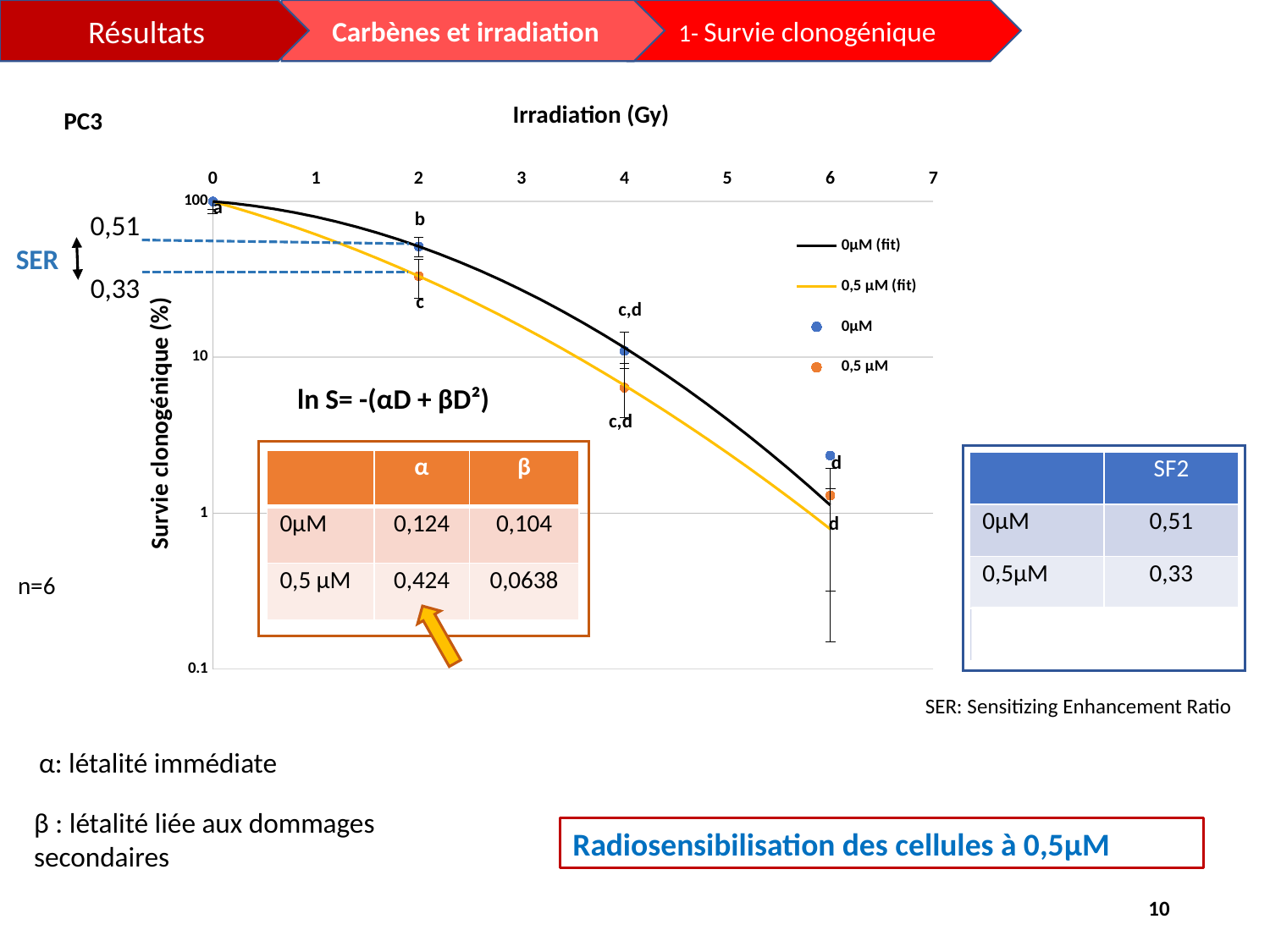
What is the title of the y axis of the chart? Survie clonogénique (%) What is the title of the x axis of the chart? Irradiation (Gy) What kind of chart is shown on the slide? scatter chart with fitted curves How many irradiation doses have plotted data points for each series? 4 At 4 Gy, is the survival value for 0,5 µM greater or less than 10? less At 4 Gy, is the survival value for 0µM greater or less than 10? greater At 6 Gy, which series has the lower clonogenic survival, 0µM or 0,5 µM? 0,5 µM How many entries does the chart legend list? 4 At 6 Gy, is the survival value for 0µM greater or less than 1? greater Does clonogenic survival rise or fall as the irradiation dose increases? fall At 4 Gy, which series has the higher clonogenic survival, 0µM or 0,5 µM? 0µM At which irradiation dose is clonogenic survival lowest for both series? 6 Gy